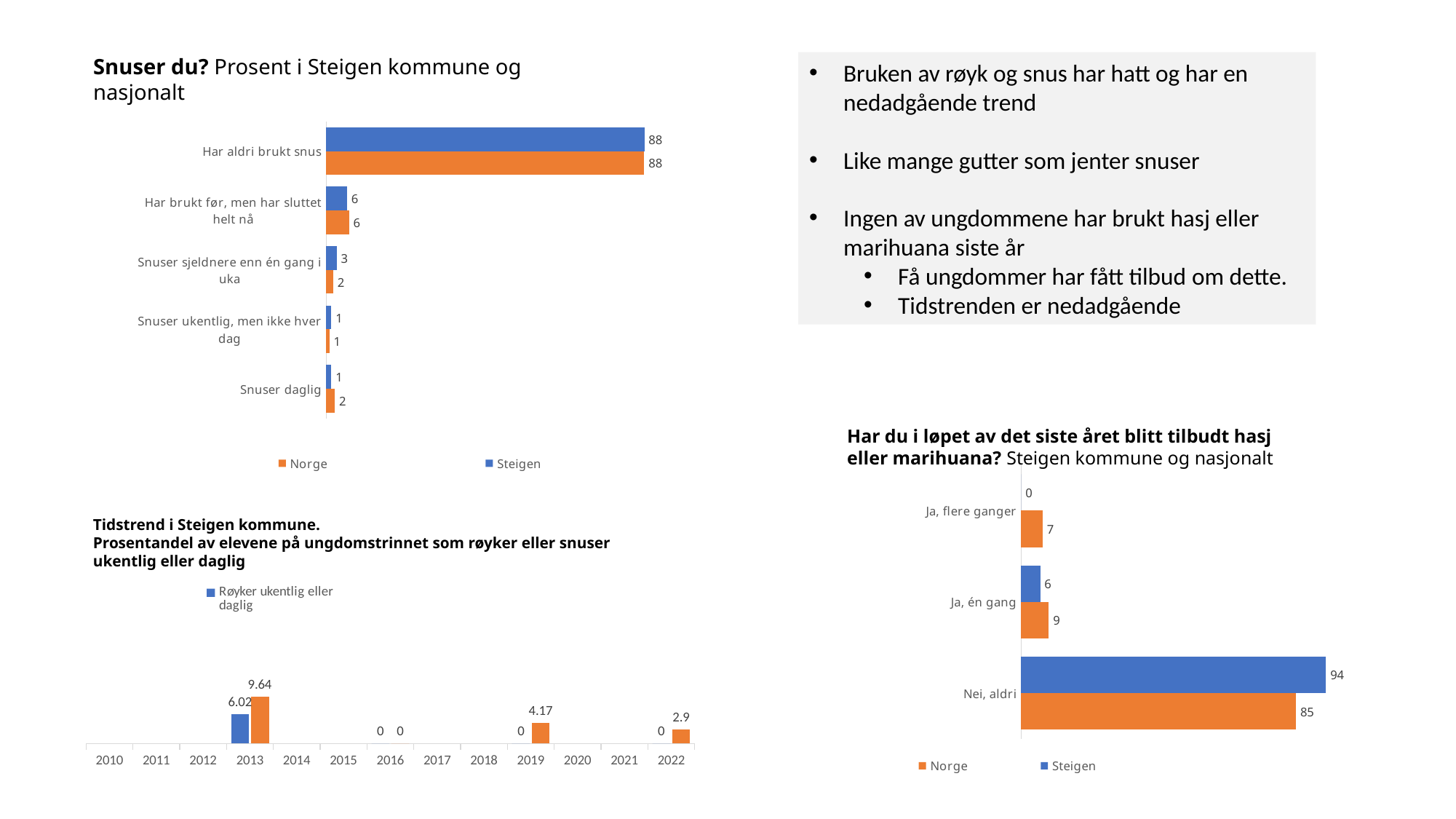
In the 'Snuser du?' chart, which is larger for 'Snuser sjeldnere enn én gang i uka': Steigen or Norge? Steigen In the 'Snuser du?' chart, what is the value for Steigen for 'Har aldri brukt snus'? 88 In the 'Har du i løpet av det siste året blitt tilbudt hasj eller marihuana?' chart, which colour represents Norge? Orange What kind of chart is the 'Snuser du?' chart? Bar chart In the 'Snuser du?' chart, what is the value for Norge for 'Snuser daglig'? 2 In the 'Tidstrend i Steigen kommune' chart, what is the highest value shown? 9.64 In the 'Har du i løpet av det siste året blitt tilbudt hasj eller marihuana?' chart, what is the value for Steigen for 'Nei, aldri'? 94 In the 'Har du i løpet av det siste året blitt tilbudt hasj eller marihuana?' chart, what is the difference between Steigen and Norge for 'Nei, aldri'? 9 In the 'Snuser du?' chart, how many categories are shown? 5 In the 'Tidstrend i Steigen kommune' chart, what is the value for 'Røyker ukentlig eller daglig' in 2013? 6.02 In the 'Snuser du?' chart, how many series does the legend list? 2 In the 'Har du i løpet av det siste året blitt tilbudt hasj eller marihuana?' chart, what is the value for Norge for 'Ja, flere ganger'? 7